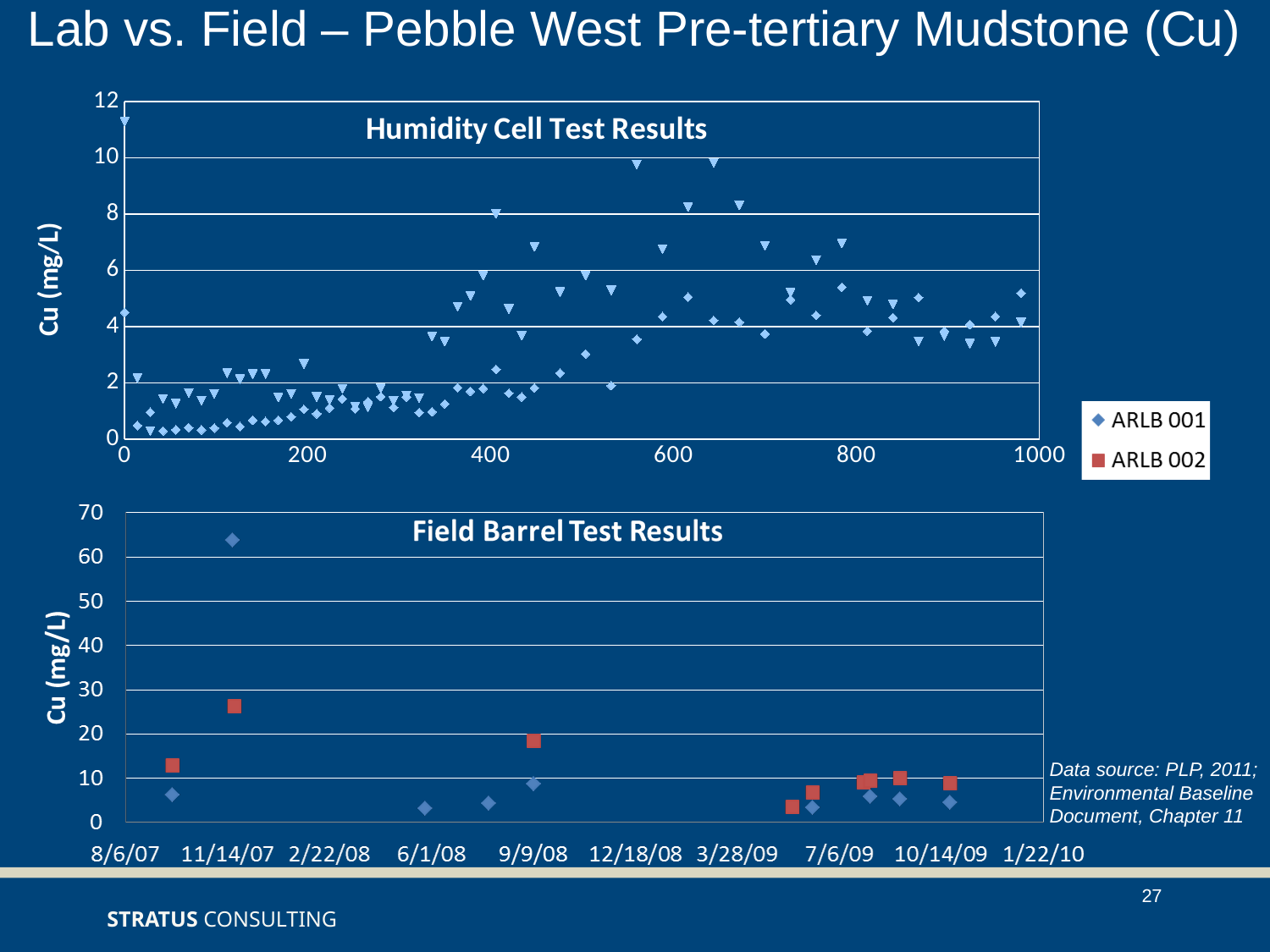
In the Humidity Cell Test Results chart, is the highest plotted value greater or less than 10? greater What kind of chart is the Humidity Cell Test Results chart? Scatter chart In the Field Barrel Test Results chart, which series has the larger value at 11/14/07, ARLB 001 or ARLB 002? ARLB 001 What is the y-axis label on both charts? Cu (mg/L) In the Field Barrel Test Results chart, is the ARLB 001 value at 6/1/08 greater or less than 10? less What kind of chart is the Field Barrel Test Results chart? Scatter chart In the Field Barrel Test Results chart, is the ARLB 002 value at 11/14/07 greater or less than 30? less What are the two series named in the legend? ARLB 001 and ARLB 002 In the Field Barrel Test Results chart, which series contains the highest plotted value? ARLB 001 How many series does the legend list? 2